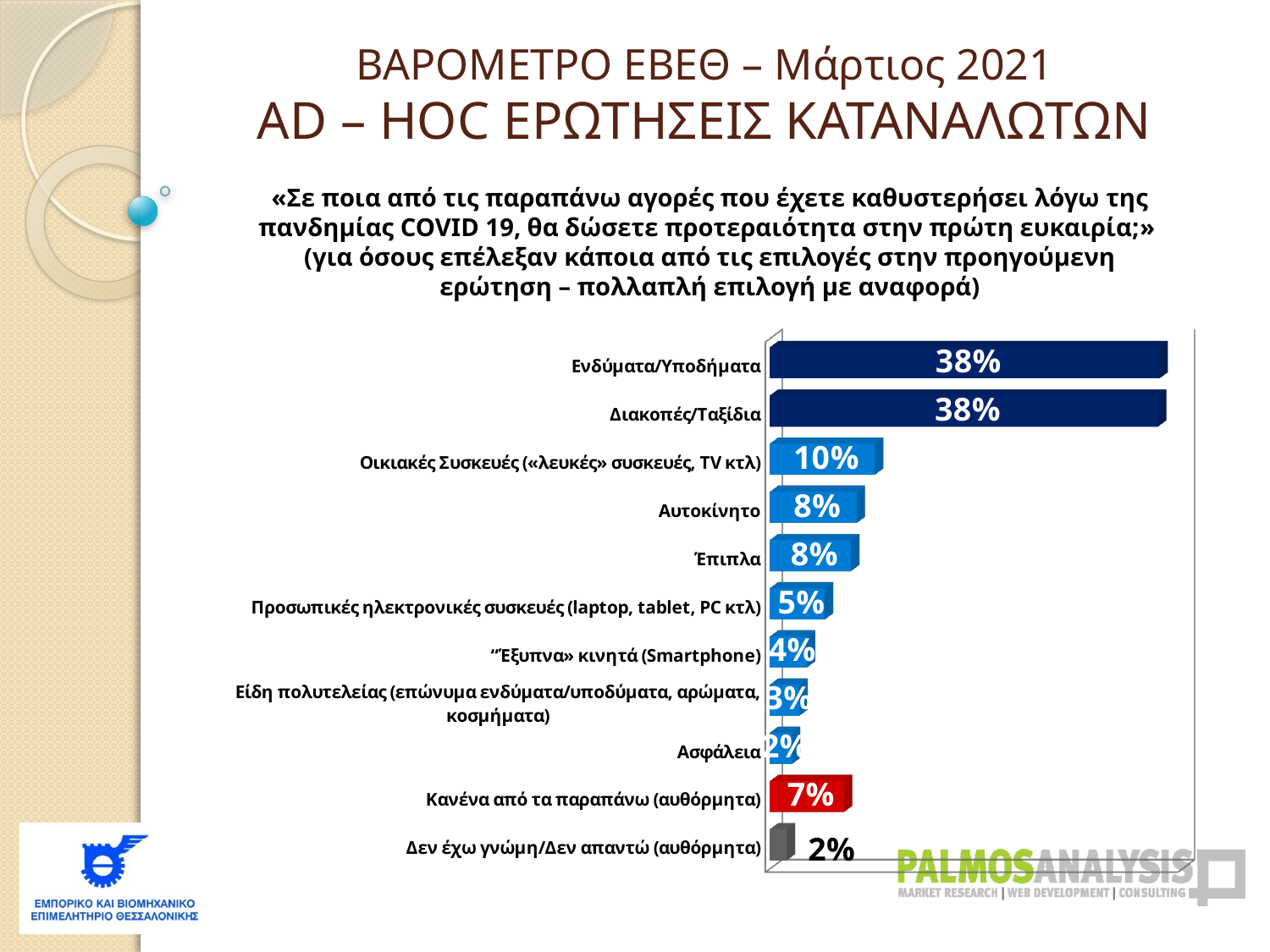
What kind of chart is shown on the slide? bar chart What is the value for Οικιακές Συσκευές («λευκές» συσκευές, TV κτλ)? 10% What is the difference between the values for Ενδύματα/Υποδήματα and Οικιακές Συσκευές («λευκές» συσκευές, TV κτλ)? 28 percentage points What is the value for Δεν έχω γνώμη/Δεν απαντώ (αυθόρμητα)? 2% What is the value for Κανένα από τα παραπάνω (αυθόρμητα)? 7% What is the value for Διακοπές/Ταξίδια? 38% Which has a larger value, Αυτοκίνητο or Κανένα από τα παραπάνω (αυθόρμητα)? Αυτοκίνητο What is the value for Ενδύματα/Υποδήματα? 38% What is the value for Προσωπικές ηλεκτρονικές συσκευές (laptop, tablet, PC κτλ)? 5% What is the value for Αυτοκίνητο? 8% How many categories are shown in the chart? 11 Which has a larger value, Έπιπλα or Έξυπνα κινητά (Smartphone)? Έπιπλα